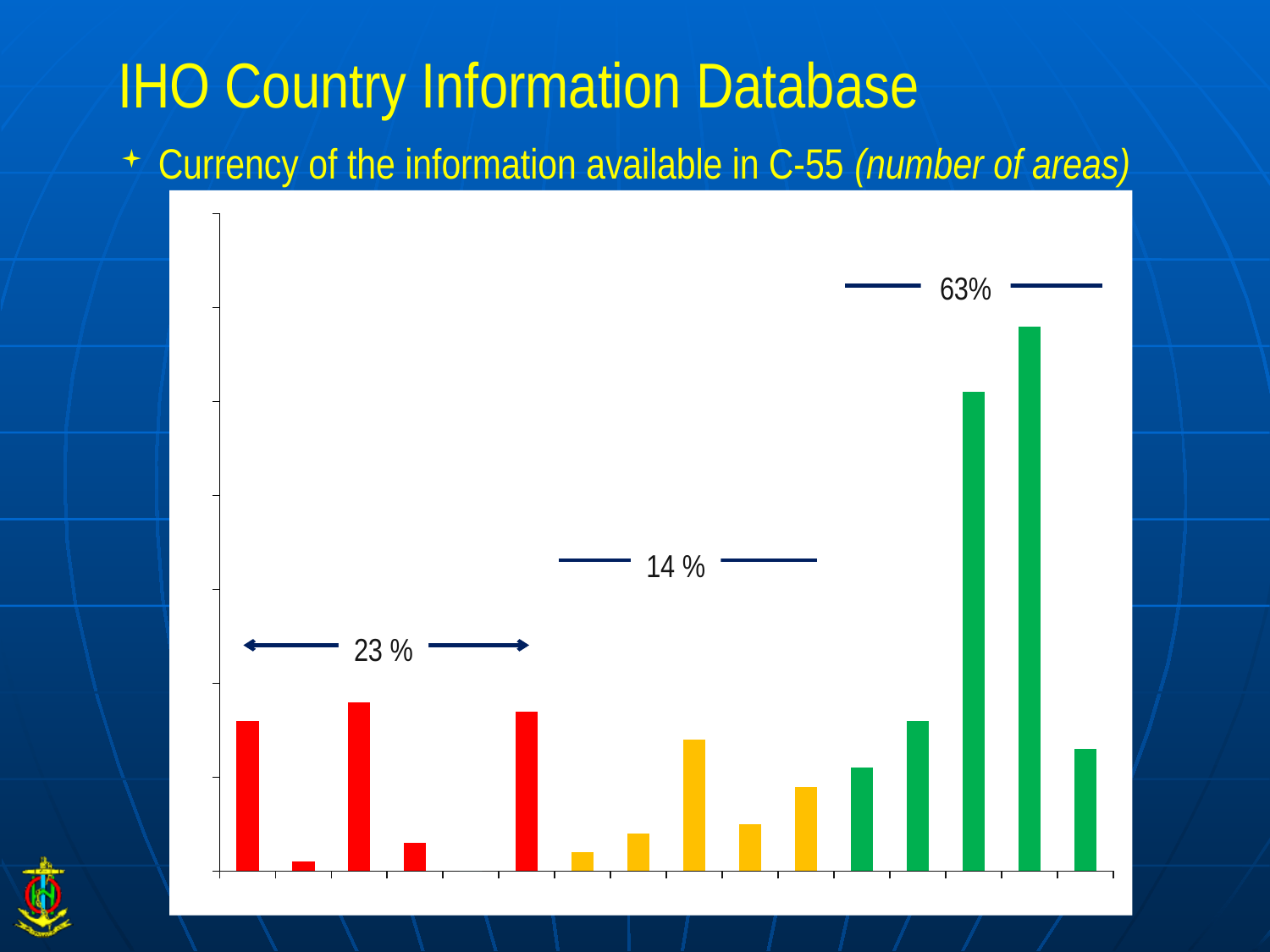
How many different bar colours are used on the chart? 3 What percentage is annotated above the group of yellow bars? 14 % Which of the three annotated percentages on the chart is the highest? 63% Which of the three annotated percentages on the chart is the lowest? 14 % How many green bars are plotted on the chart? 5 What is the title of the slide containing the chart? IHO Country Information Database Is the annotated percentage for the red group larger or smaller than that for the yellow group? larger What percentage is annotated above the group of red bars? 23 % How many yellow bars are plotted on the chart? 5 What percentage is annotated above the group of green bars? 63% What kind of chart is shown on the slide? bar chart Which colour group contains the tallest bar on the chart? green